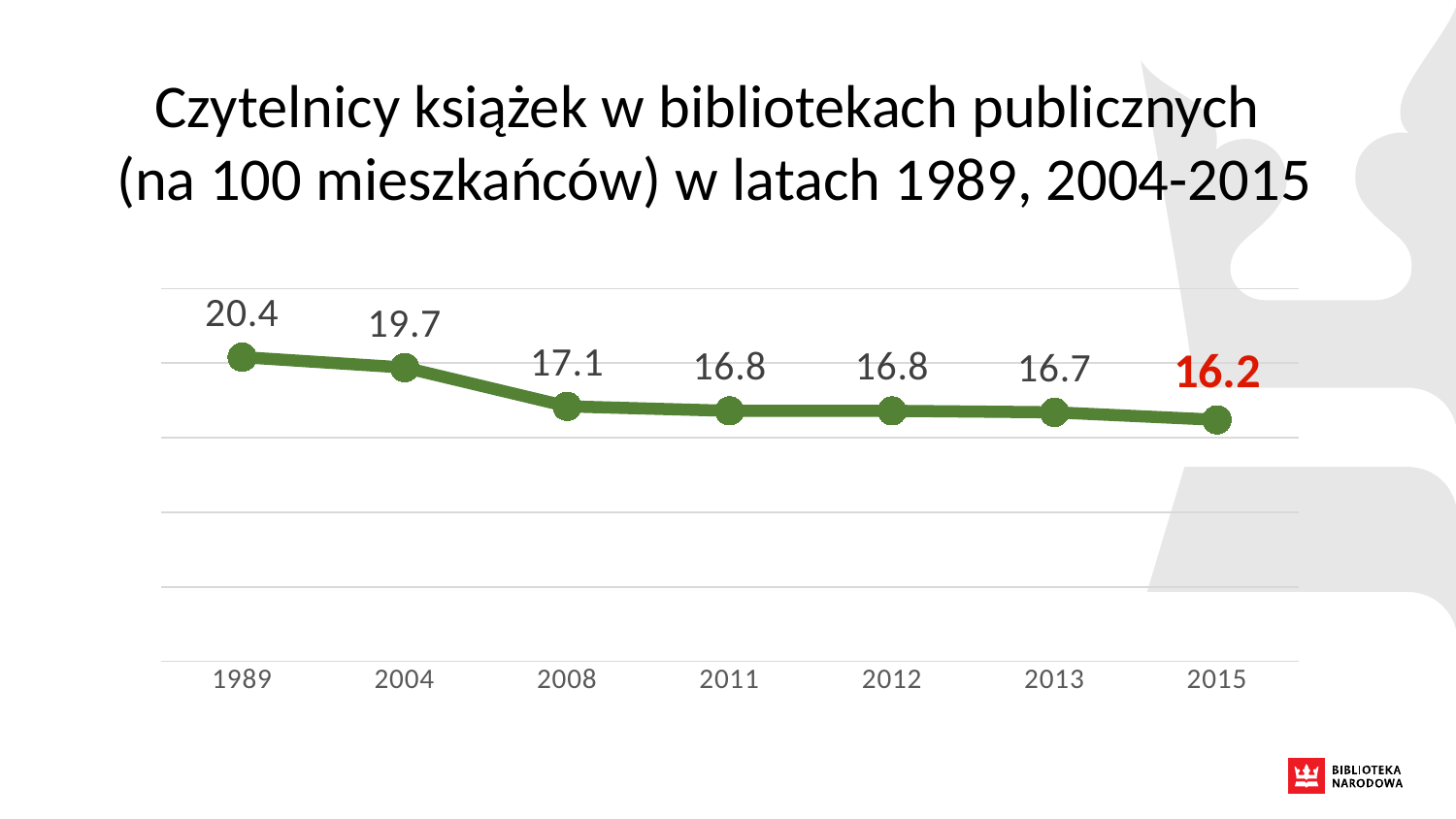
Which is larger, the value for 2004 or the value for 2013? 2004 Which year has the lowest value? 2015 What is the value for 2015? 16.2 Which year has the highest value? 1989 What kind of chart is shown on the slide? line chart What is the value for 1989? 20.4 Do the values rise or fall from 1989 to 2015? fall What is the value for 2008? 17.1 What is the value for 2013? 16.7 How many data points are plotted on the chart? 7 What is the difference between the values for 1989 and 2015? 4.2 What is the difference between the values for 2004 and 2008? 2.6